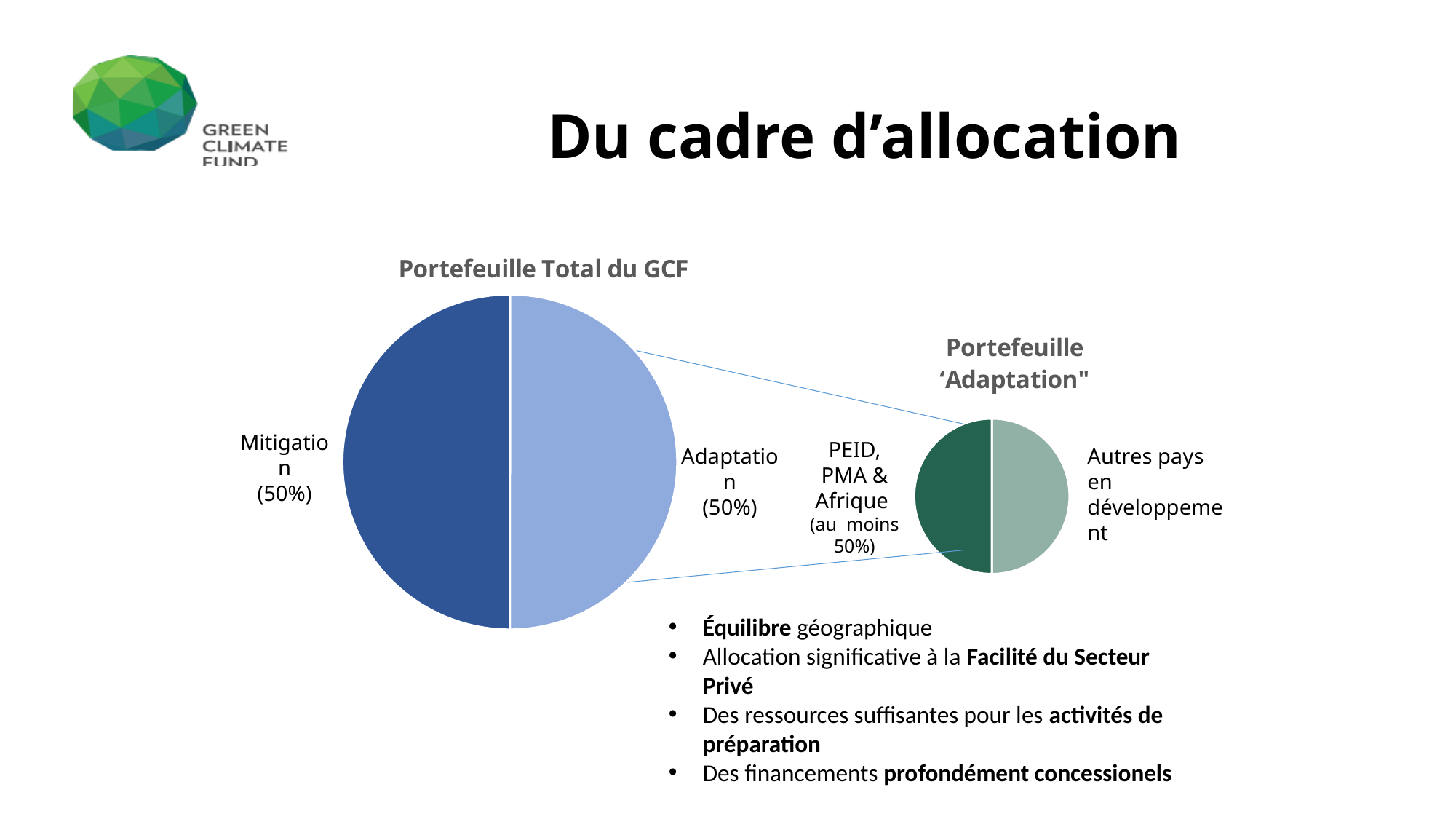
In the 'Portefeuille Adaptation' chart, what share is indicated for PEID, PMA & Afrique? au moins 50% In the 'Portefeuille Total du GCF' chart, what colour is the Mitigation slice? Dark blue In the 'Portefeuille Total du GCF' chart, how many slices does the pie have? 2 In the 'Portefeuille Total du GCF' chart, what are the two categories shown? Mitigation and Adaptation In the 'Portefeuille Adaptation' chart, how many slices does the pie have? 2 What kind of chart is the 'Portefeuille Adaptation' chart? Pie chart In the 'Portefeuille Total du GCF' chart, what share is allocated to Mitigation? 50% In the 'Portefeuille Adaptation' chart, what is the label of the slice other than 'PEID, PMA & Afrique'? Autres pays en développement How many pie charts are shown on the slide? 2 What kind of chart is the 'Portefeuille Total du GCF' chart? Pie chart What is the title of the larger pie chart on the left? Portefeuille Total du GCF In the 'Portefeuille Total du GCF' chart, what share is allocated to Adaptation? 50%